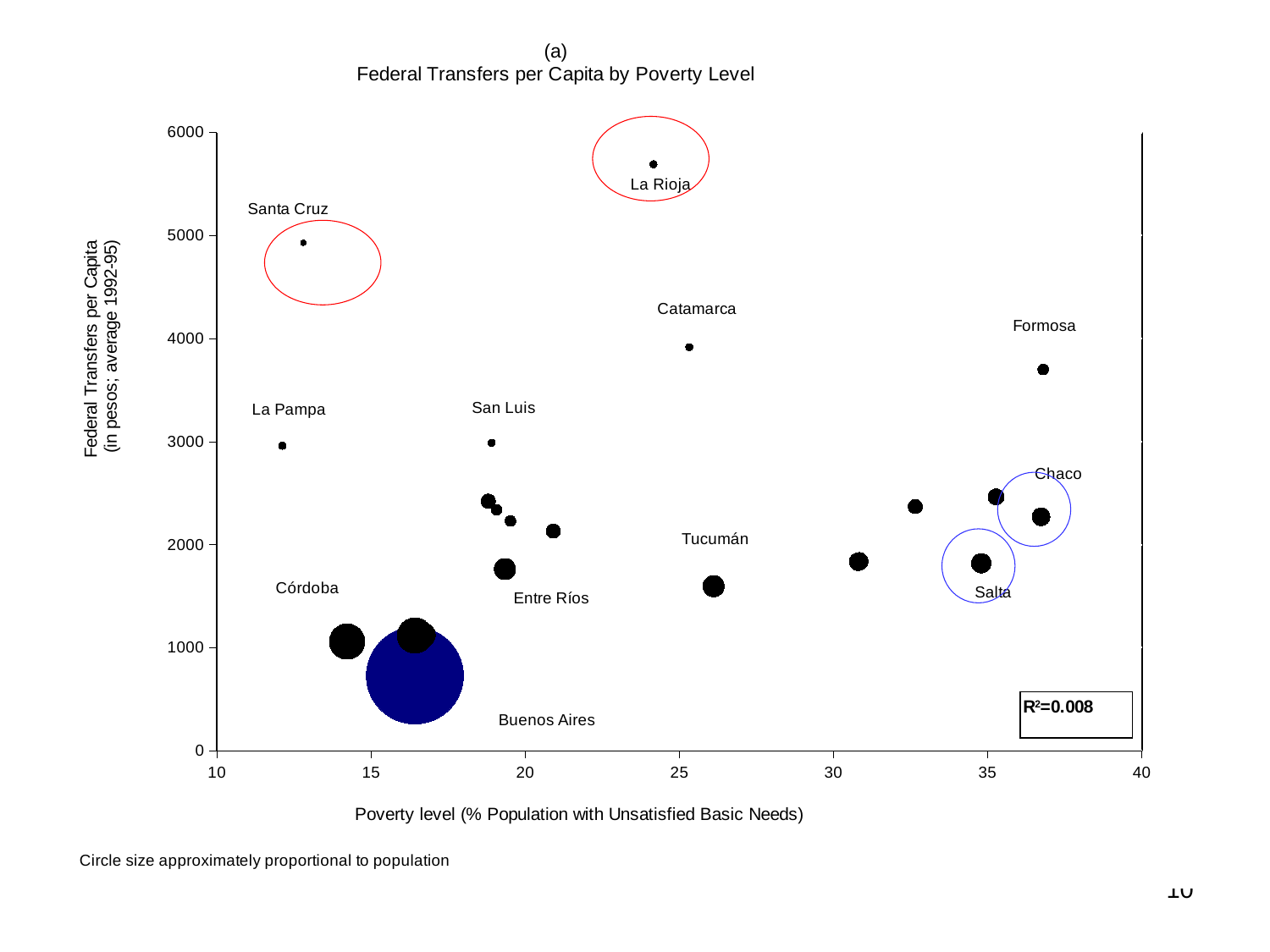
Is the federal transfers per capita value for La Rioja greater or less than 5000? greater What R² value is printed on the chart? R²=0.008 Which province has the highest federal transfers per capita? La Rioja Is the federal transfers per capita value for Buenos Aires greater or less than 1000? less Which has higher federal transfers per capita, La Rioja or Santa Cruz? La Rioja Which has a higher poverty level, Formosa or Catamarca? Formosa Which province has the lowest federal transfers per capita? Buenos Aires According to the note below the chart, what is circle size proportional to? Population What kind of chart is shown on the slide? Bubble (scatter) chart Is the poverty level for Formosa greater or less than 35? greater